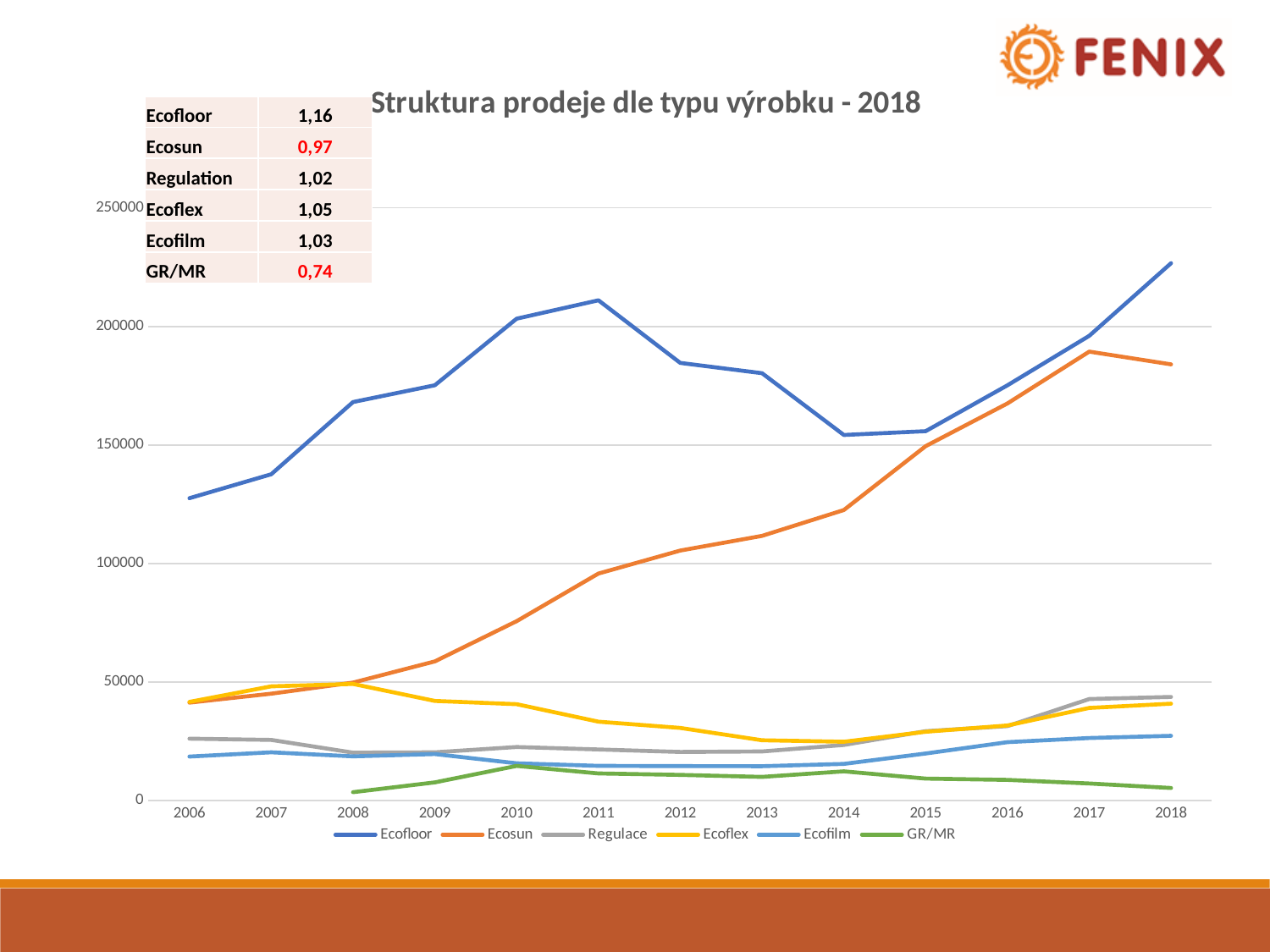
Which series has the highest value in 2018? Ecofloor Which series has the lowest value in 2018? GR/MR How many series does the chart legend list? 6 Which is larger in 2011, the value for Ecofloor or the value for Ecosun? Ecofloor Is the value for Ecofloor in 2018 greater or less than 200000? greater How many years are shown along the x axis of the chart? 13 Is the value for Ecofloor in 2006 greater or less than 100000? greater Does the Ecosun series rise or fall from 2006 to 2017? rise What is the title of the chart? Struktura prodeje dle typu výrobku - 2018 In which year does the Ecofloor series have its lowest value? 2006 Is the value for Ecosun in 2018 greater or less than 200000? less What kind of chart is shown on the slide? line chart